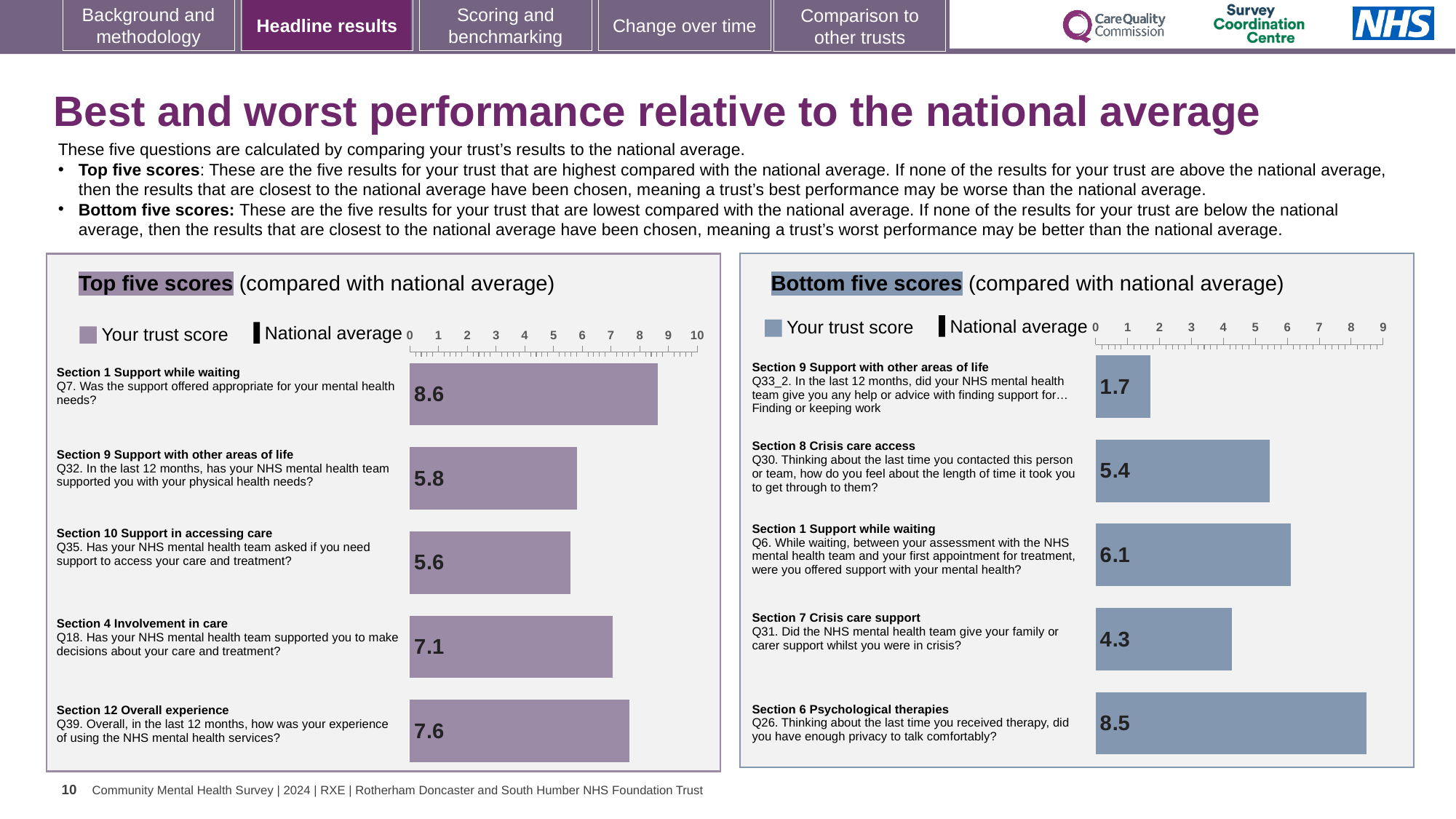
In the Bottom five scores chart, which has the larger trust score: Q30 or Q6? Q6 In the Bottom five scores chart, which question has the lowest trust score? Q33_2 (Section 9 Support with other areas of life) How many bars are plotted in the Top five scores chart? 5 What two entries does the legend of the Top five scores chart list? Your trust score and National average In the Top five scores chart, what is the trust score for Q39 (Overall experience of using the NHS mental health services)? 7.6 In the Top five scores chart, which question has the highest trust score? Q7 (Section 1 Support while waiting) In the Bottom five scores chart, what is the trust score for Q31 (Did the NHS mental health team give your family or carer support whilst you were in crisis?)? 4.3 In the Top five scores chart, what is the difference between the trust scores for Q7 and Q35? 3.0 In the Bottom five scores chart, what is the difference between the trust scores for Q26 and Q33_2? 6.8 In the Top five scores chart, what is the trust score for Q7 (Was the support offered appropriate for your mental health needs?)? 8.6 In the Bottom five scores chart, which question has the highest trust score? Q26 (Section 6 Psychological therapies) What type of chart is the Bottom five scores chart? Bar chart